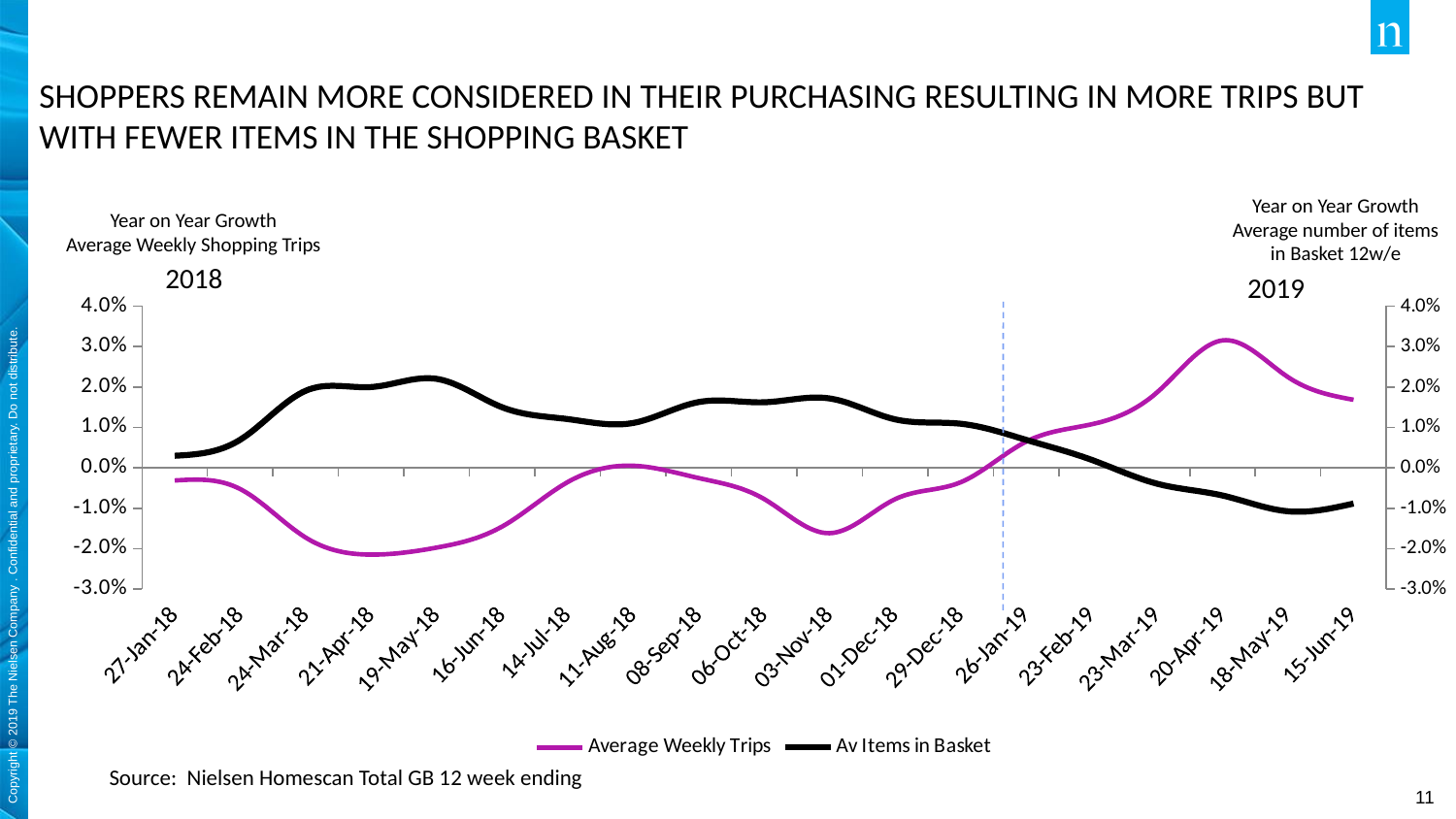
How many dates are labelled on the x axis? 19 Is the value for Average Weekly Trips at 20-Apr-19 greater or less than 2.0%? greater How many series does the legend list? 2 At 20-Apr-19, which series has the higher value, Average Weekly Trips or Av Items in Basket? Average Weekly Trips At 19-May-18, which series has the higher value, Average Weekly Trips or Av Items in Basket? Av Items in Basket Is the value for Average Weekly Trips at 21-Apr-18 greater or less than -1.0%? less Which two series are named in the legend? Average Weekly Trips and Av Items in Basket Is the value for Av Items in Basket at 19-May-18 greater or less than 1.0%? greater On which date does the Average Weekly Trips series reach its highest value? 20-Apr-19 Does the Av Items in Basket series rise or fall between 26-Jan-19 and 18-May-19? fall What kind of chart is shown on the slide? line chart